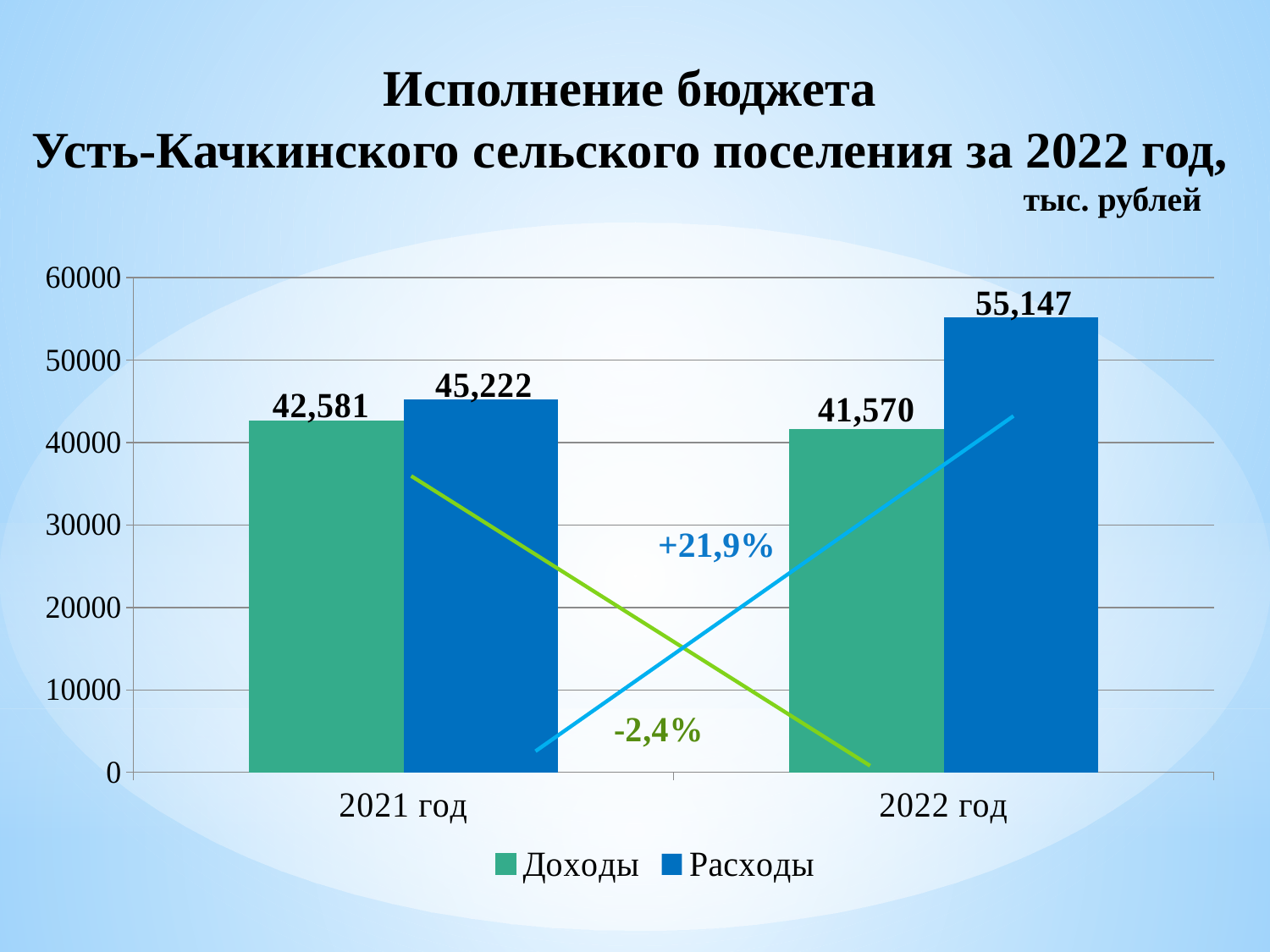
Which bar has the lowest value on the chart? Доходы, 2022 год Which bar has the highest value on the chart? Расходы, 2022 год What is the difference between Расходы and Доходы for 2022 год? 13,577 What is the value of Расходы for 2021 год? 45,222 What kind of chart is shown on the slide? Bar chart What is the value of Доходы for 2021 год? 42,581 Do the Расходы values rise or fall from 2021 год to 2022 год? Rise What is the value of Расходы for 2022 год? 55,147 How many series does the legend list? 2 Which is larger for 2021 год: Доходы or Расходы? Расходы What is the value of Доходы for 2022 год? 41,570 What is the difference between Расходы in 2022 год and Расходы in 2021 год? 9,925